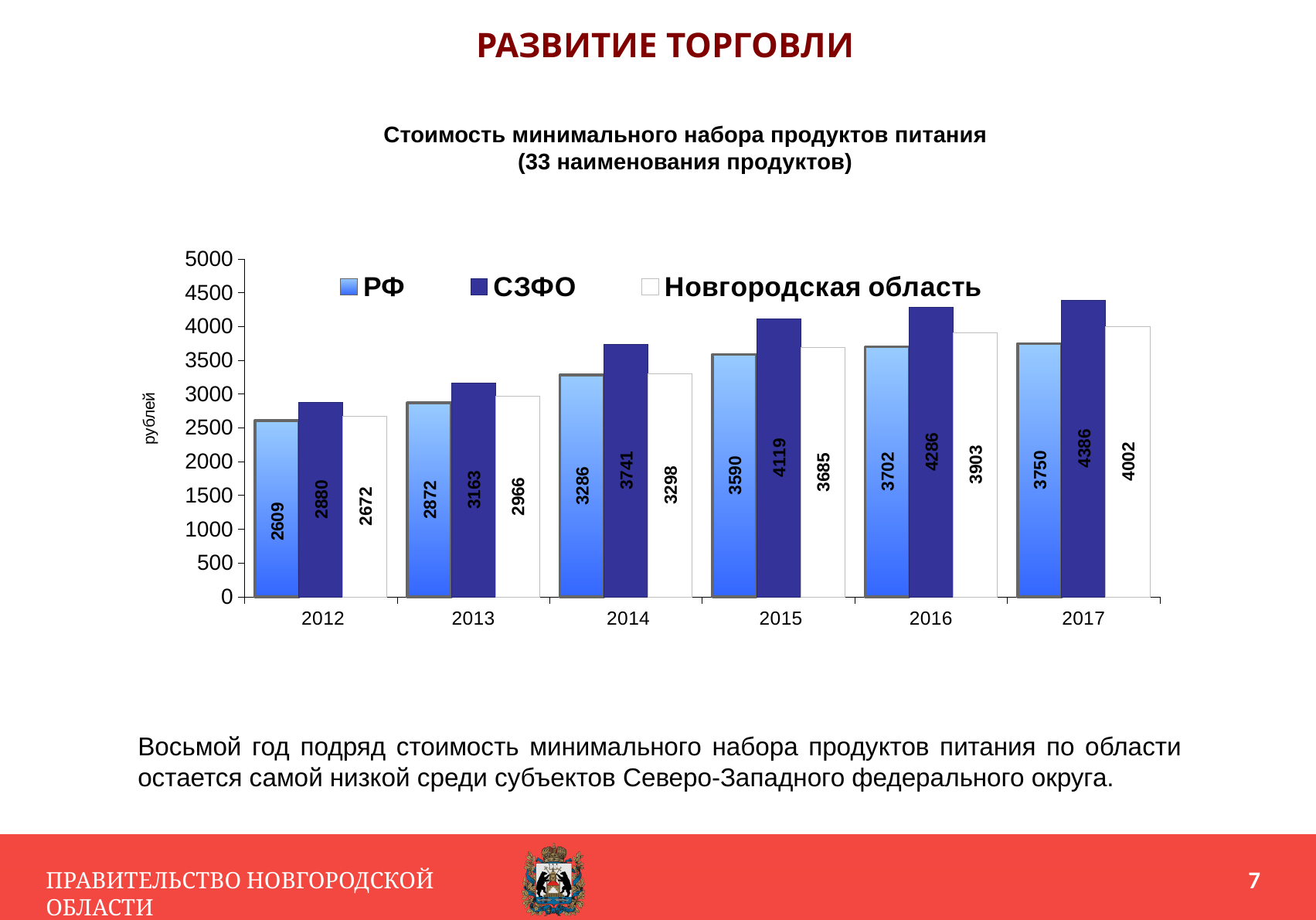
How many series does the legend list? 3 Which is larger in 2015: the value for РФ or the value for Новгородская область? Новгородская область What is the value for СЗФО in 2017? 4386 Is the value for СЗФО in 2013 greater or less than 3000? greater What is the value for Новгородская область in 2012? 2672 Do the values for Новгородская область rise or fall from 2012 to 2017? rise What is the difference between the СЗФО and Новгородская область values in 2016? 383 In which year is the value for СЗФО the highest? 2017 How many years are shown on the x axis? 6 What kind of chart is shown on the slide? bar chart In which year is the value for РФ the lowest? 2012 What is the value for РФ in 2014? 3286